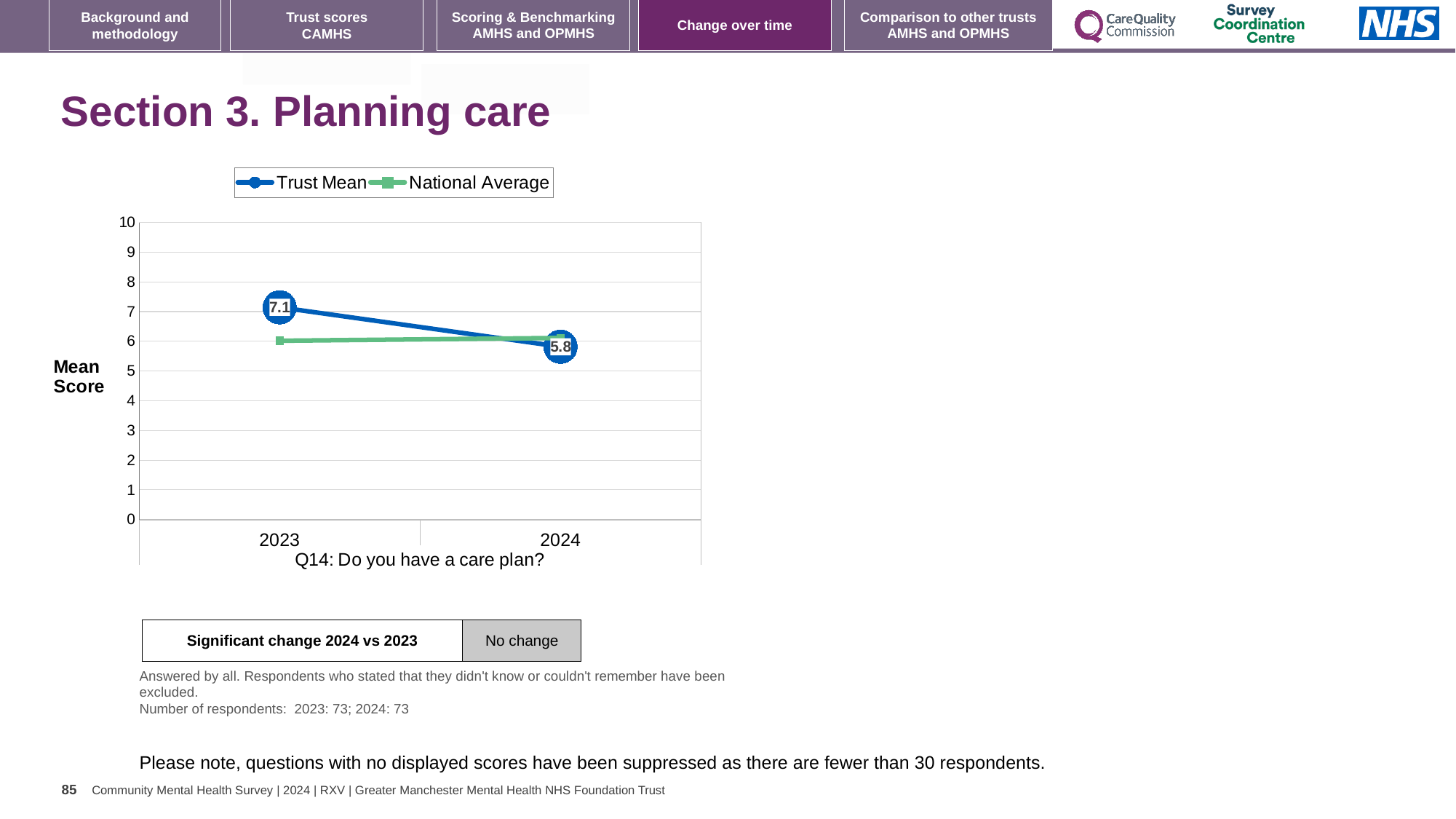
How many years are plotted on the x axis? 2 In 2023, which is larger: the Trust Mean or the National Average? Trust Mean Does the Trust Mean score rise or fall from 2023 to 2024? fall In which year is the Trust Mean score highest? 2023 What is the Trust Mean score for 2023? 7.1 Is the National Average for 2023 greater or less than 7? less What kind of chart is shown on the slide? line chart In which year is the Trust Mean score lowest? 2024 Is the National Average for 2024 greater or less than 5? greater How many series does the legend list? 2 By how much did the Trust Mean score change from 2023 to 2024? 1.3 What is the Trust Mean score for 2024? 5.8